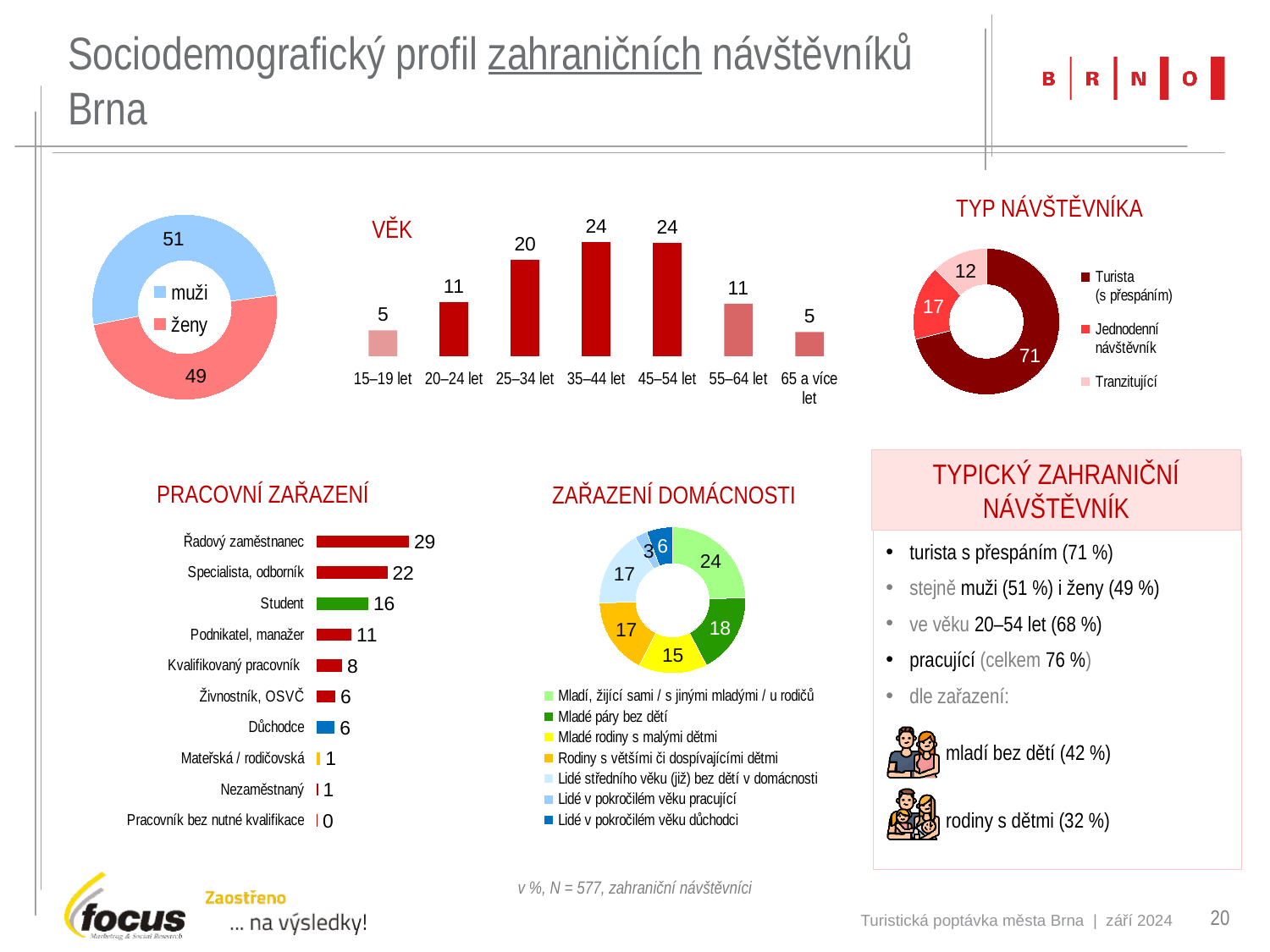
In the TYP NÁVŠTĚVNÍKA chart, what is the value for Jednodenní návštěvník? 17 What kind of chart is PRACOVNÍ ZAŘAZENÍ? Bar chart In the PRACOVNÍ ZAŘAZENÍ chart, which category has the highest value? Řadový zaměstnanec In the PRACOVNÍ ZAŘAZENÍ chart, what is the value for Student? 16 In the gender donut chart on the left, what is the value for muži? 51 In the VĚK chart, how many age categories are shown? 7 How many entries does the legend of the ZAŘAZENÍ DOMÁCNOSTI chart list? 7 In the VĚK chart, which age groups have the highest value? 35–44 let and 45–54 let In the VĚK chart, what is the difference between the values for 20–24 let and 15–19 let? 6 In the ZAŘAZENÍ DOMÁCNOSTI chart, what is the value for Mladé páry bez dětí? 18 In the TYP NÁVŠTĚVNÍKA chart, which category has the lowest value? Tranzitující In the VĚK chart, what is the value for the 25–34 let age group? 20